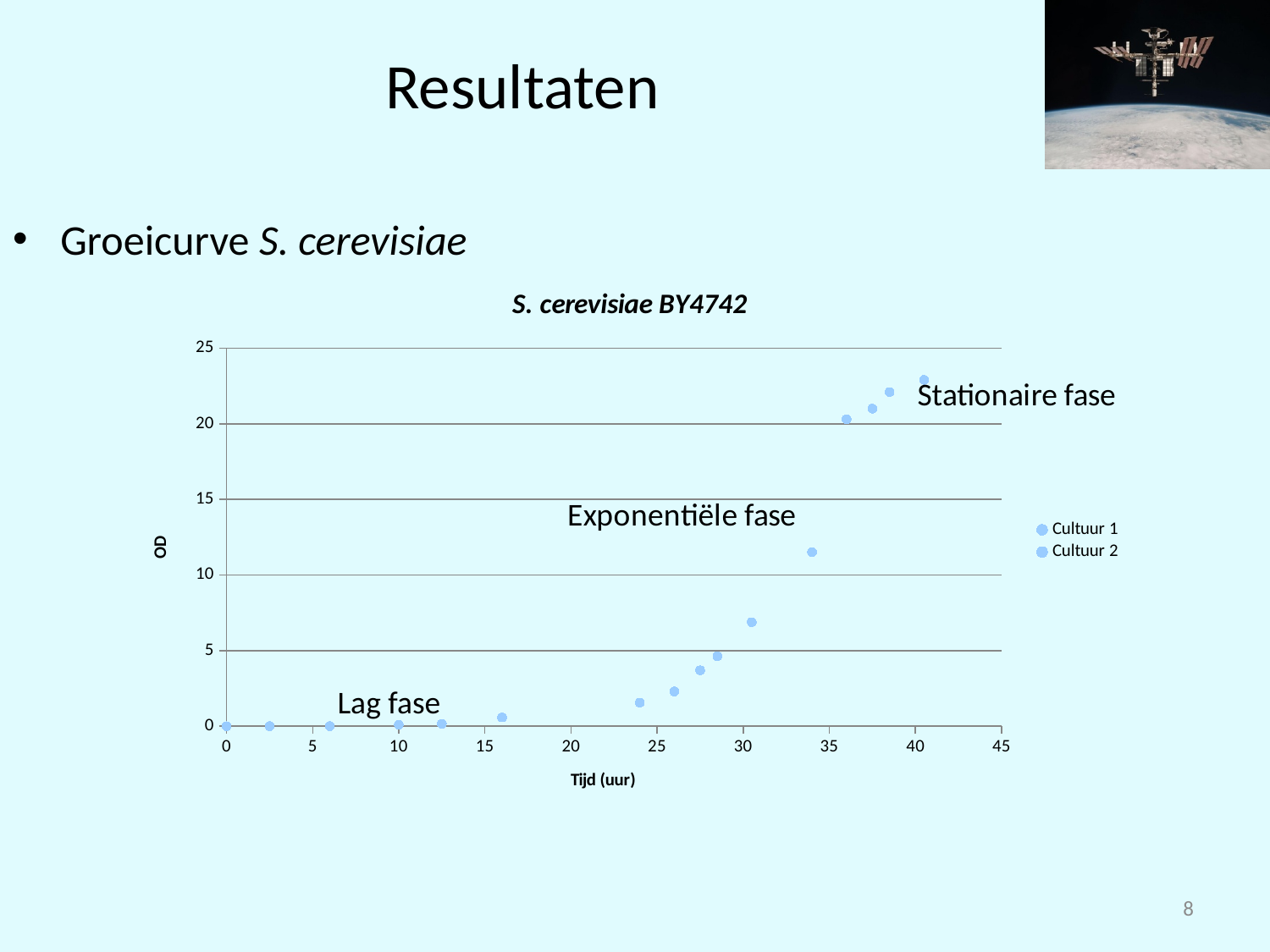
What is the highest value shown on the y axis? 25 What are the two series named in the legend? Cultuur 1, Cultuur 2 Is the OD value at around 30 hours greater or less than 10? less Is the OD value at around 26 hours greater or less than 5? less Which is larger, the OD value at around 34 hours or the OD value at around 28 hours? the value at around 34 hours Do the OD values rise or fall as time (Tijd) increases along the x axis? rise Is the OD value at around 34 hours greater or less than 10? greater What is the title of the chart? S. cerevisiae BY4742 What kind of chart is shown on the slide? scatter chart How many series does the legend list? 2